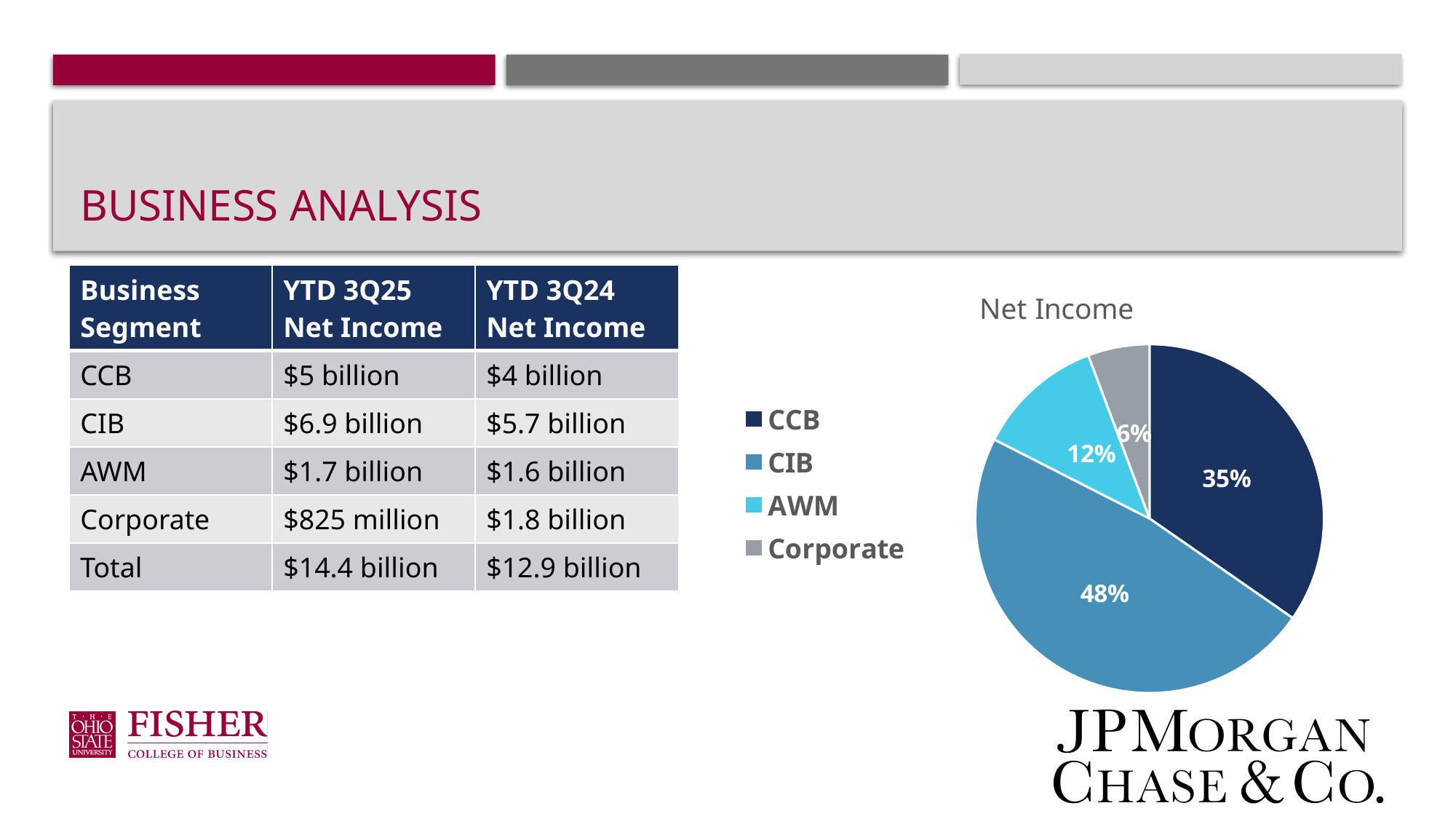
Which segment has the smallest slice in the Net Income pie chart? Corporate How many slices does the Net Income pie chart have? 4 What share of the Net Income pie does CIB represent? 48% By how many percentage points does the CIB slice exceed the CCB slice in the Net Income pie chart? 13 percentage points What share of the Net Income pie does Corporate represent? 6% What kind of chart is shown on the slide? pie chart Which segment has the largest slice in the Net Income pie chart? CIB What share of the Net Income pie does AWM represent? 12% Which slice is larger in the Net Income pie chart, CCB or AWM? CCB How many entries does the legend of the Net Income pie chart list? 4 What is the title of the pie chart? Net Income